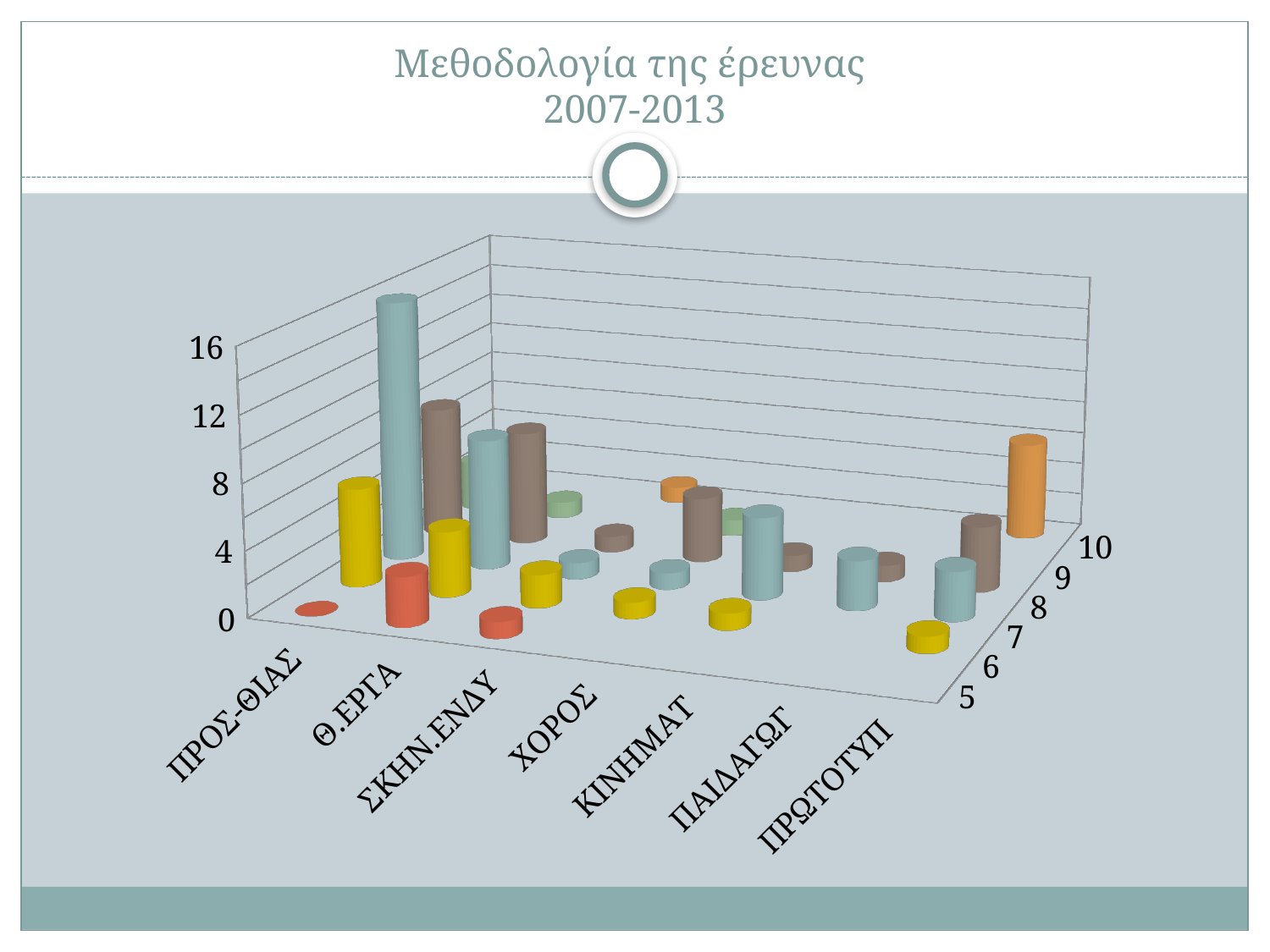
What is the last label on the depth axis of the chart? 10 How many categories are labelled along the horizontal axis of the chart? 7 What kind of chart is shown on the slide? bar chart Which category has the tallest bar: Θ.ΕΡΓΑ or ΠΡΟΣ-ΘΙΑΣ? ΠΡΟΣ-ΘΙΑΣ How many labels are shown on the depth axis of the chart? 6 Is the tallest bar in the Θ.ΕΡΓΑ category greater or less than 12? less What is the title of the chart on the slide? Μεθοδολογία της έρευνας 2007-2013 Which category contains the tallest bar in the chart? ΠΡΟΣ-ΘΙΑΣ Is the tallest bar in the ΧΟΡΟΣ category greater or less than 8? less Is the tallest bar in the ΠΡΟΣ-ΘΙΑΣ category greater or less than 4? greater What is the first category label on the horizontal axis of the chart? ΠΡΟΣ-ΘΙΑΣ What is the highest value labelled on the vertical axis of the chart? 16